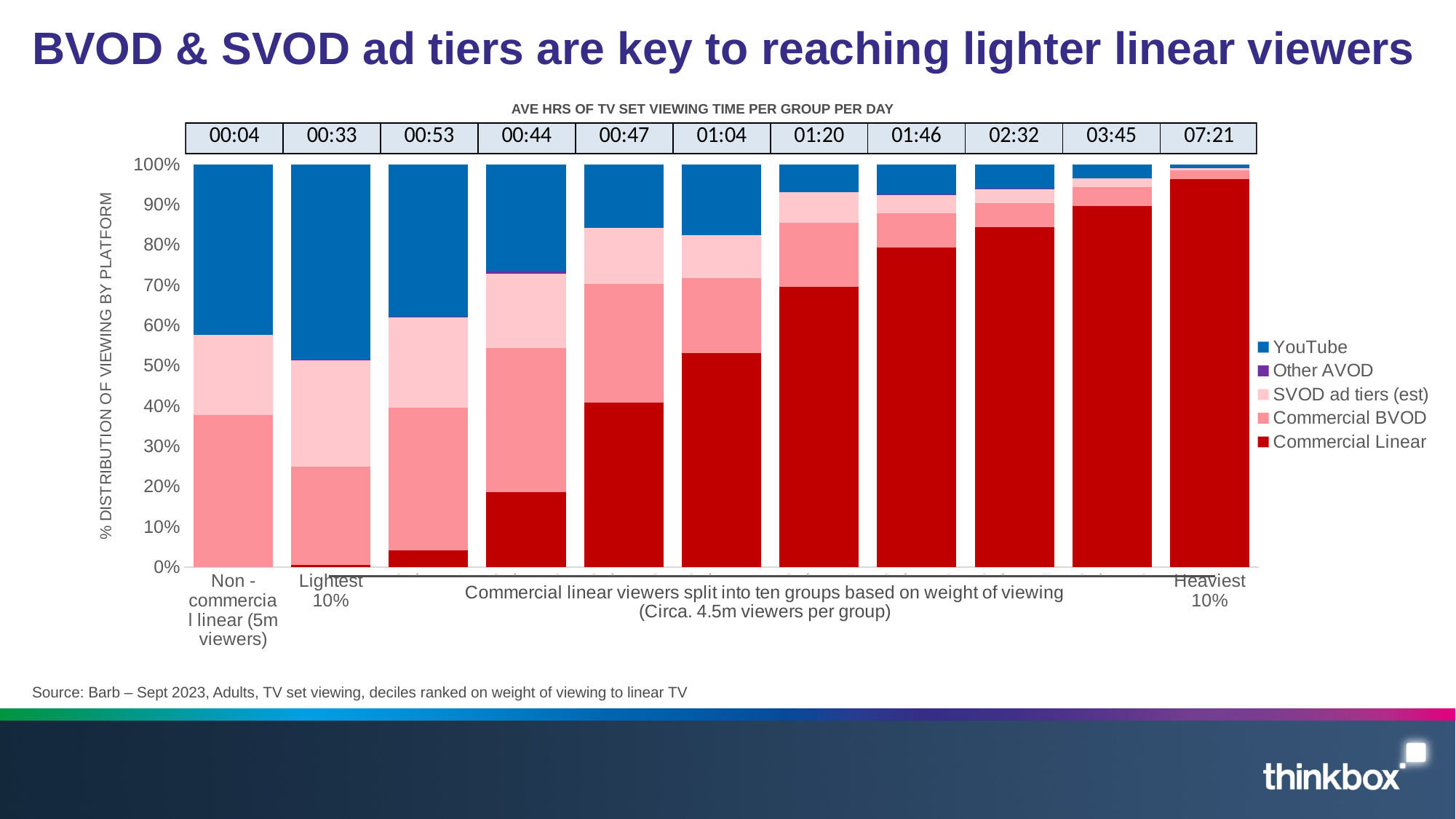
Is the Commercial Linear share for the Lightest 10% group greater or less than 10%? less How many bars (viewer groups) are plotted in the chart? 11 Does the Commercial Linear share rise or fall moving from the Lightest 10% group to the Heaviest 10% group? Rises How many series does the legend list? 5 Is the Commercial Linear share for the Heaviest 10% group greater or less than 90%? greater What is the label on the vertical axis of the chart? % DISTRIBUTION OF VIEWING BY PLATFORM What is the average hours of TV set viewing time per day shown for the Lightest 10% group? 00:33 What is the average hours of TV set viewing time per day shown for the Heaviest 10% group? 07:21 Which group has the largest Commercial Linear share of viewing? Heaviest 10% What is the average hours of TV set viewing time per day shown for the Non-commercial linear (5m viewers) group? 00:04 What kind of chart is shown on the slide? Stacked bar chart Which group has the largest YouTube share of viewing? Lightest 10%